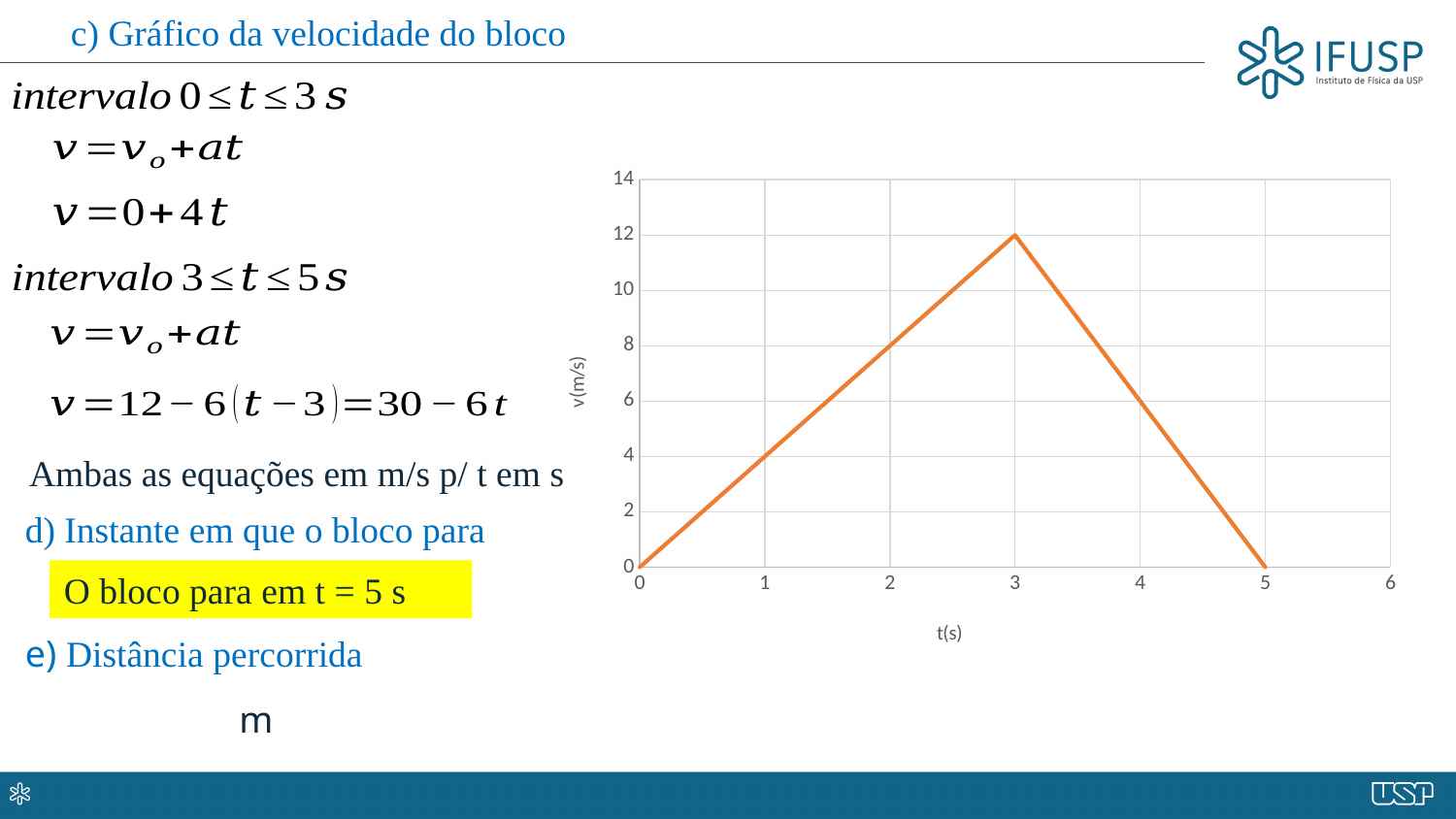
What is the velocity at t = 3 s on the chart? 12 Is the velocity at t = 4.5 s greater or less than 6? less What is the difference between the velocity at t = 3 s and at t = 5 s? 12 At what time t does the velocity reach its highest value on the chart? 3 What is the velocity at t = 5 s on the chart? 0 Does the velocity rise or fall between t = 3 and t = 5 s? fall Does the velocity rise or fall between t = 0 and t = 3 s? rise Is the velocity at t = 1.5 s greater or less than 4? greater What is the velocity at t = 0 s on the chart? 0 What kind of chart is shown on the slide? line chart Which is larger, the velocity at t = 1 s or at t = 4 s? t = 4 s What is the label of the vertical axis of the chart? v(m/s)